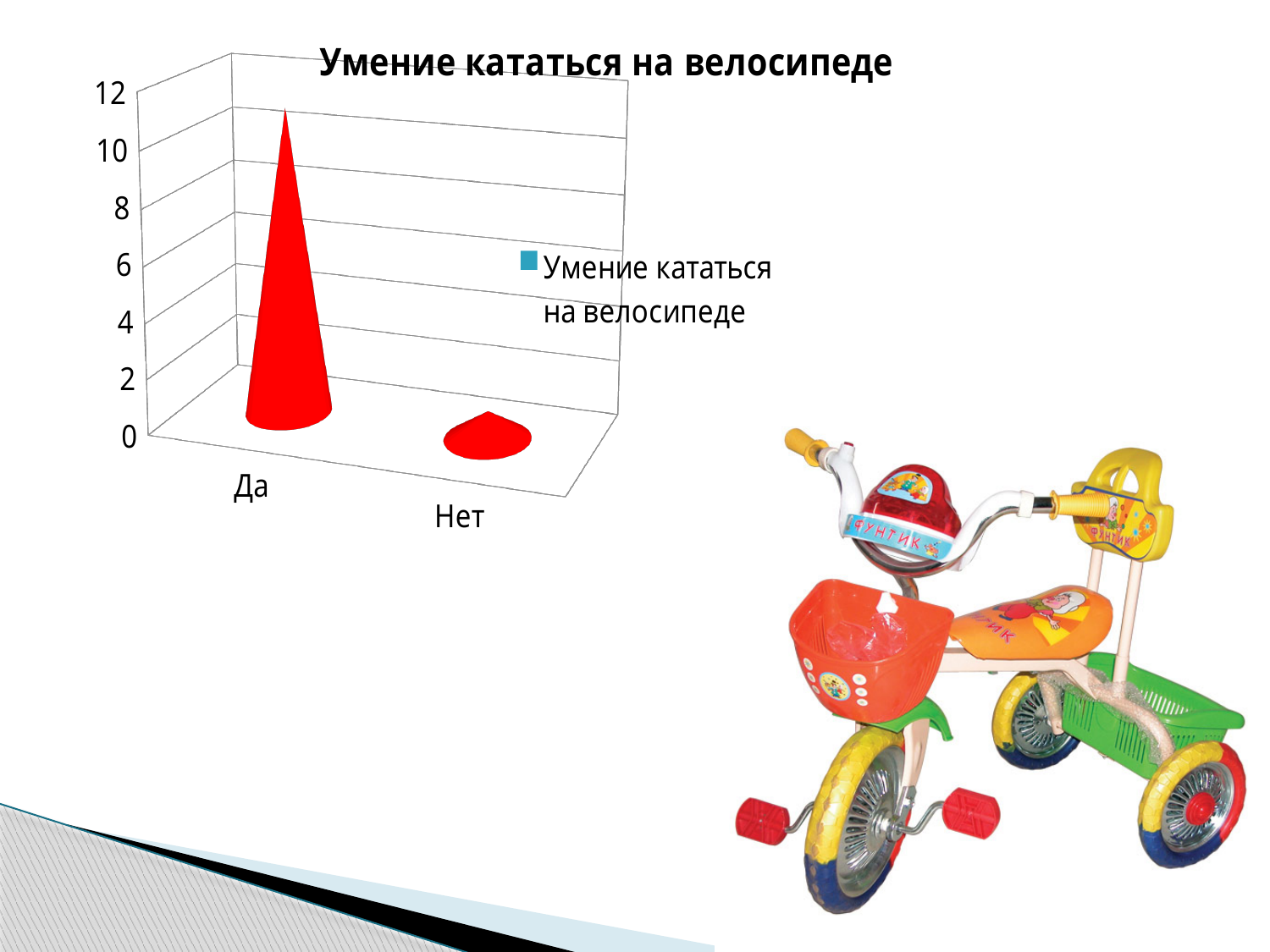
What is the title of the chart? Умение кататься на велосипеде Is the value for Нет greater or less than 2? less Do the values rise or fall from Да to Нет along the x axis? fall Is the value for Да greater or less than 8? greater How many categories are shown on the x axis of the chart? 2 Which category has the highest value in the chart? Да What series name is shown in the chart legend? Умение кататься на велосипеде What kind of chart is shown on the slide? bar chart Which category has the lowest value in the chart? Нет How many series does the chart legend list? 1 Which is larger, the value for Да or the value for Нет? Да